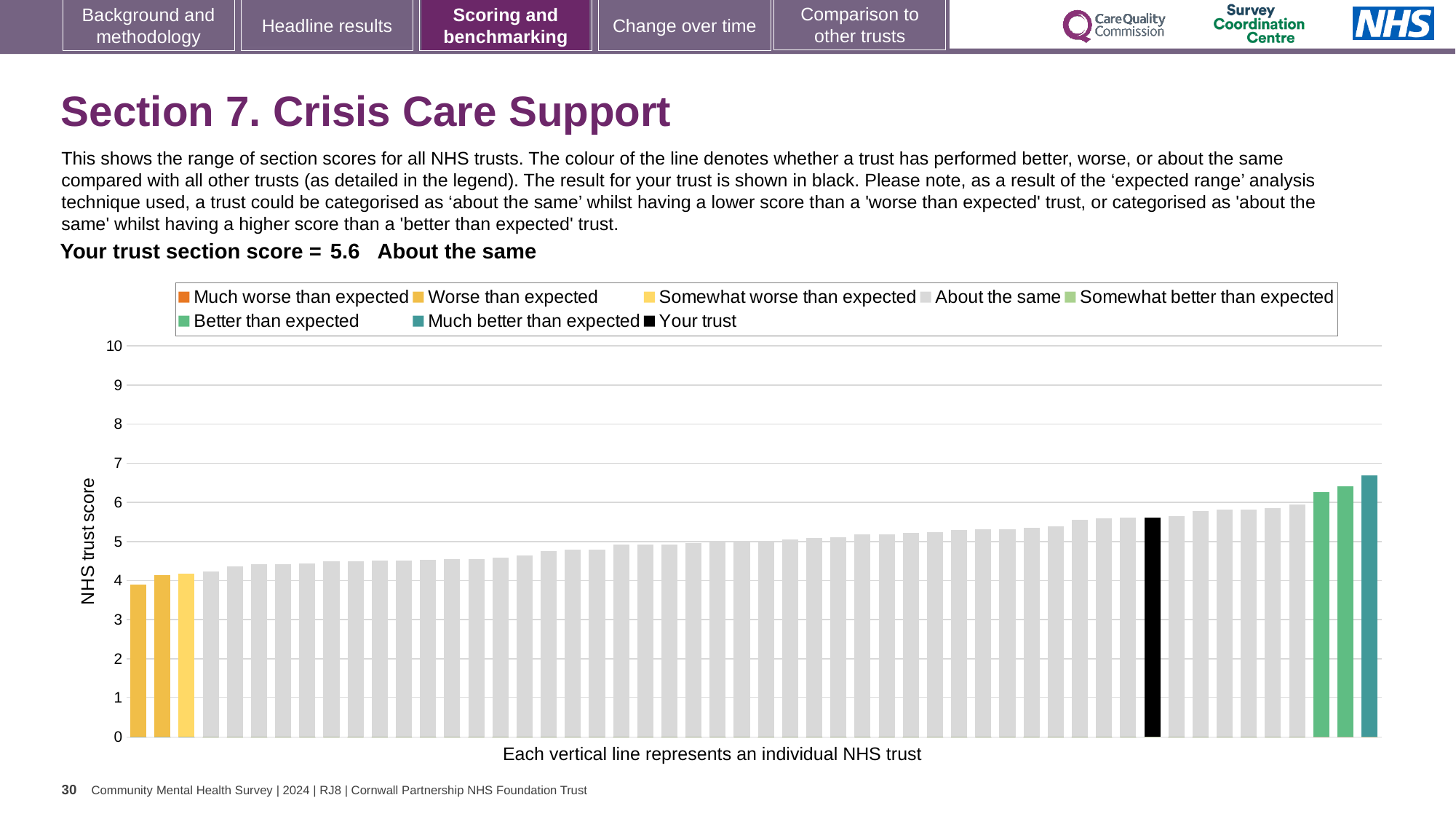
What is the section score for your trust shown on the slide? 5.6 Which is larger: the score for your trust (black bar) or the score of the leftmost bar? your trust Is the value of the shortest bar greater or less than 5? less How many entries does the chart legend list? 8 Is the value of the tallest bar greater or less than 6? greater How many bars are coloured as 'Better than expected'? 2 What colour is the bar representing your trust? black What is the label on the y axis of the chart? NHS trust score Do the bar values rise or fall from left to right along the x axis? rise What kind of chart is shown on the slide? bar chart Is the value of the tallest bar greater or less than 7? less How many bars are coloured as 'Much better than expected'? 1